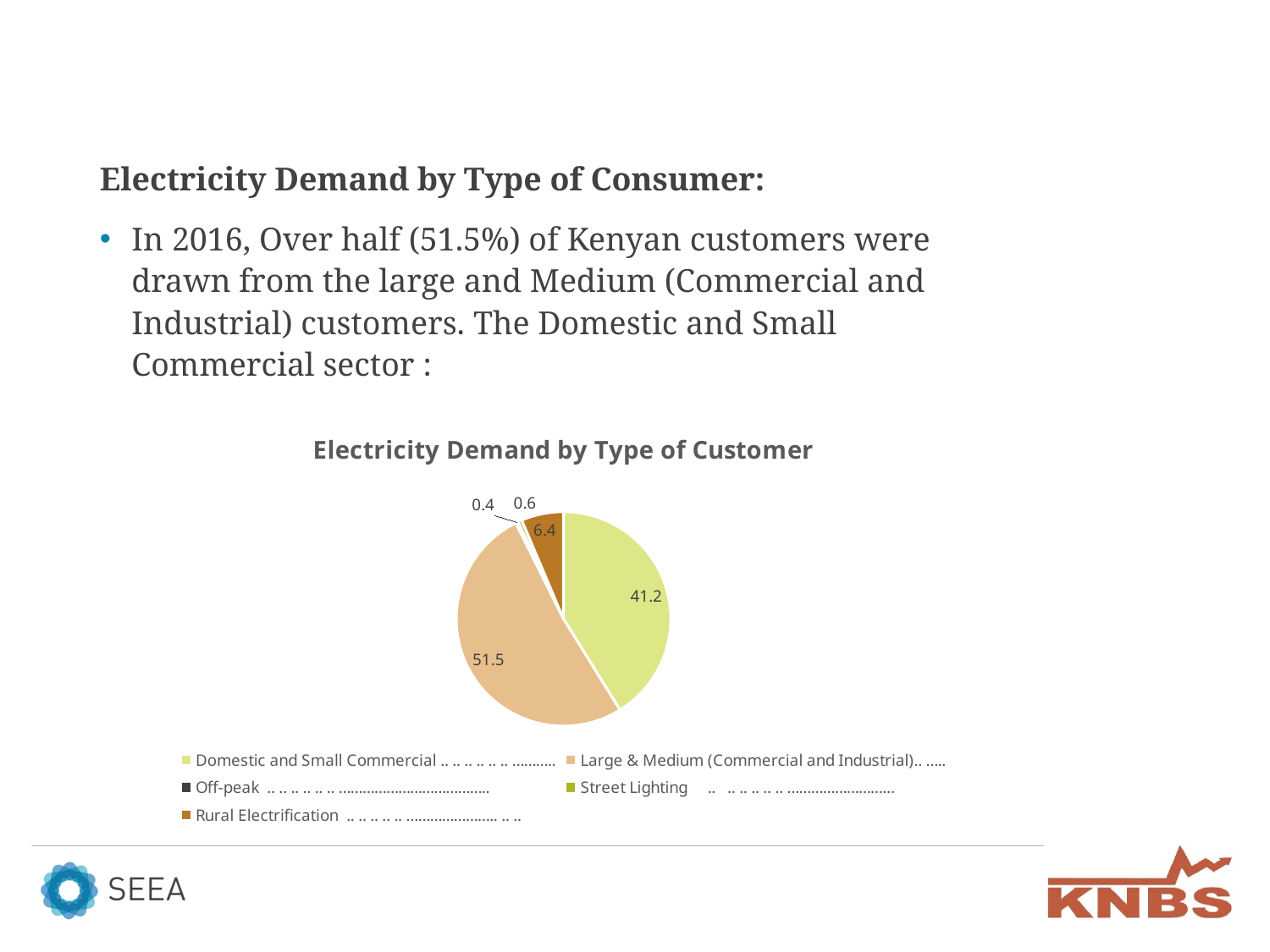
What is the difference between the Domestic and Small Commercial value and the Rural Electrification value? 34.8 What value is shown for the Domestic and Small Commercial slice in the pie chart? 41.2 Which category has the largest slice in the pie chart? Large & Medium (Commercial and Industrial) What is the combined value of the Domestic and Small Commercial and Large & Medium (Commercial and Industrial) slices? 92.7 What is the title of the chart on the slide? Electricity Demand by Type of Customer What value is shown for the Large & Medium (Commercial and Industrial) slice in the pie chart? 51.5 What is the difference between the Large & Medium (Commercial and Industrial) value and the Domestic and Small Commercial value? 10.3 What type of chart is shown on the slide? Pie chart Which is larger, the Domestic and Small Commercial slice or the Rural Electrification slice? Domestic and Small Commercial What is the smallest value labelled on the pie chart? 0.4 What value is shown for the Rural Electrification slice in the pie chart? 6.4 How many categories does the pie chart legend list? 5